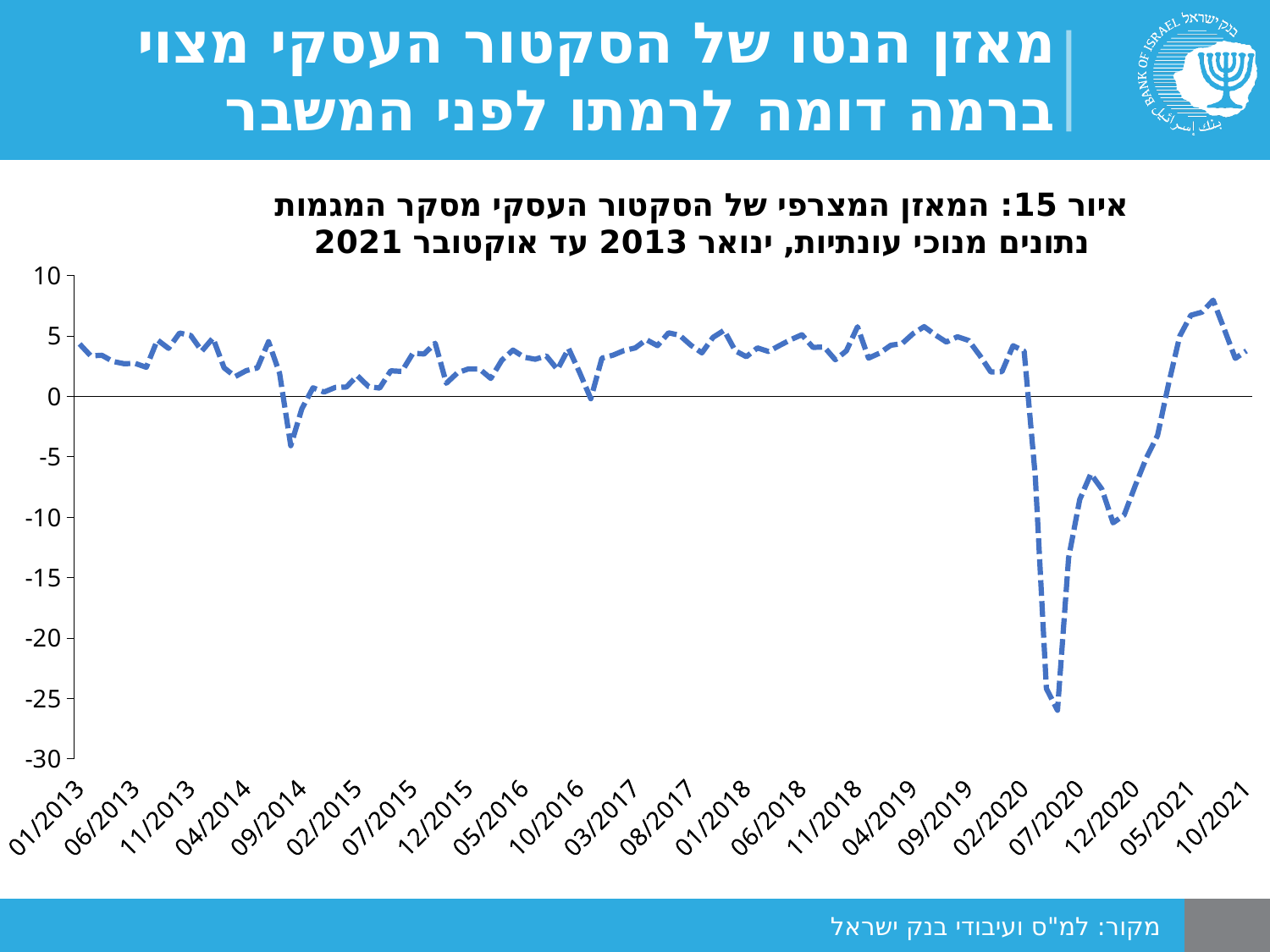
Is the value at 10/2021 greater or less than 5? less Is the value at 01/2013 greater or less than 0? greater What is the first date label on the x axis? 01/2013 In which year does the line reach its lowest value? 2020 Is the value at 07/2020 greater or less than -5? less What kind of chart is shown on the slide? line chart How many date labels are shown on the x axis? 22 In which year does the line reach its highest value? 2021 What is the lowest value shown on the y axis? -30 Does the line rise or fall between 07/2020 and 05/2021? rise Which is larger, the value at 07/2020 or the value at 10/2021? 10/2021